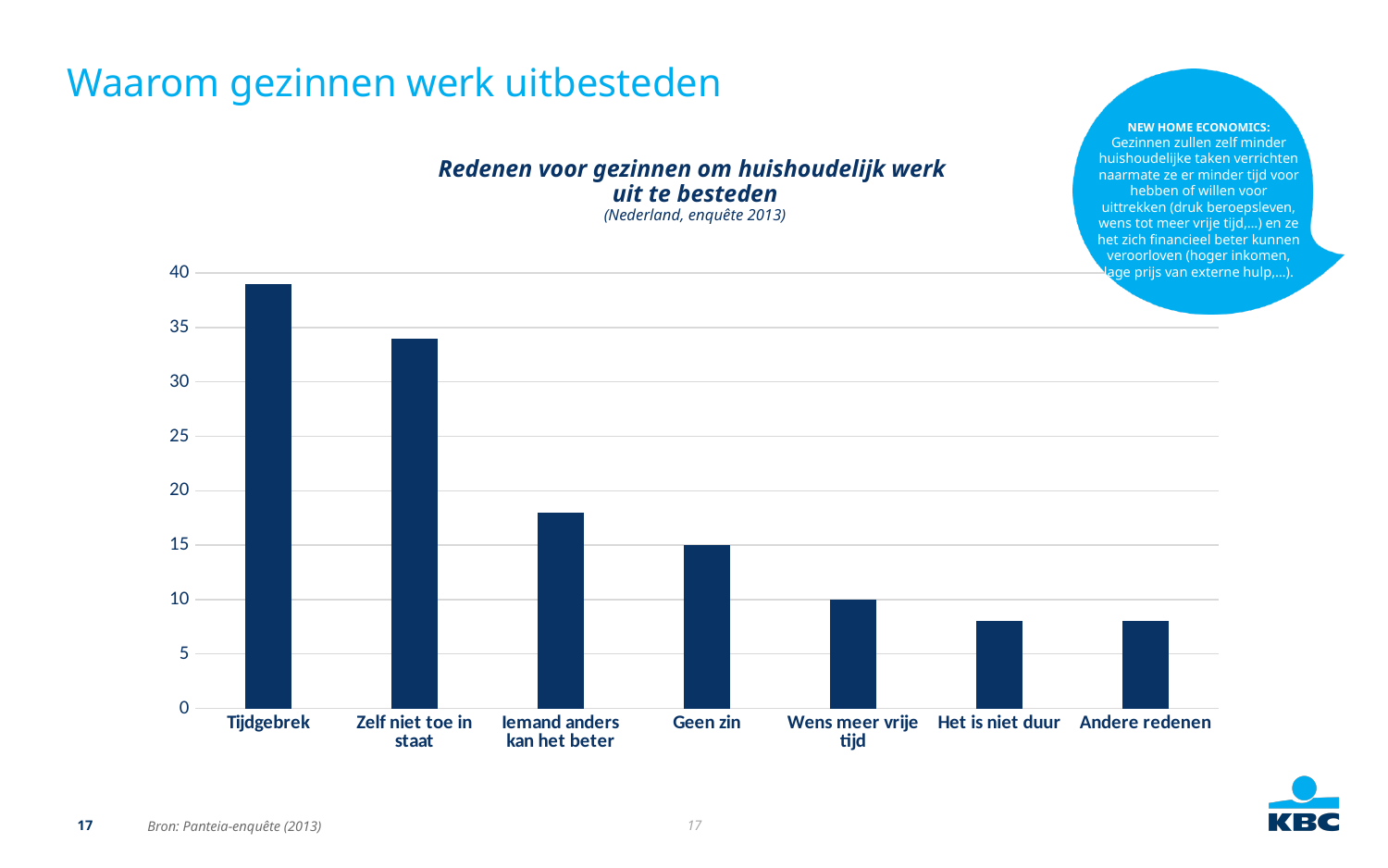
What kind of chart is shown on the slide? Bar chart Is the value for Iemand anders kan het beter greater or less than 15? greater Do the bar values rise or fall from left to right along the x axis? fall Which is larger, the value for Tijdgebrek or the value for Zelf niet toe in staat? Tijdgebrek What is the value for Wens meer vrije tijd? 10 Is the value for Tijdgebrek greater or less than 35? greater What is the value for Geen zin? 15 What is the title of the chart? Redenen voor gezinnen om huishoudelijk werk uit te besteden How many categories (reasons) are shown on the x axis of the chart? 7 Is the value for Zelf niet toe in staat greater or less than 35? less Which reason has the highest bar in the chart? Tijdgebrek